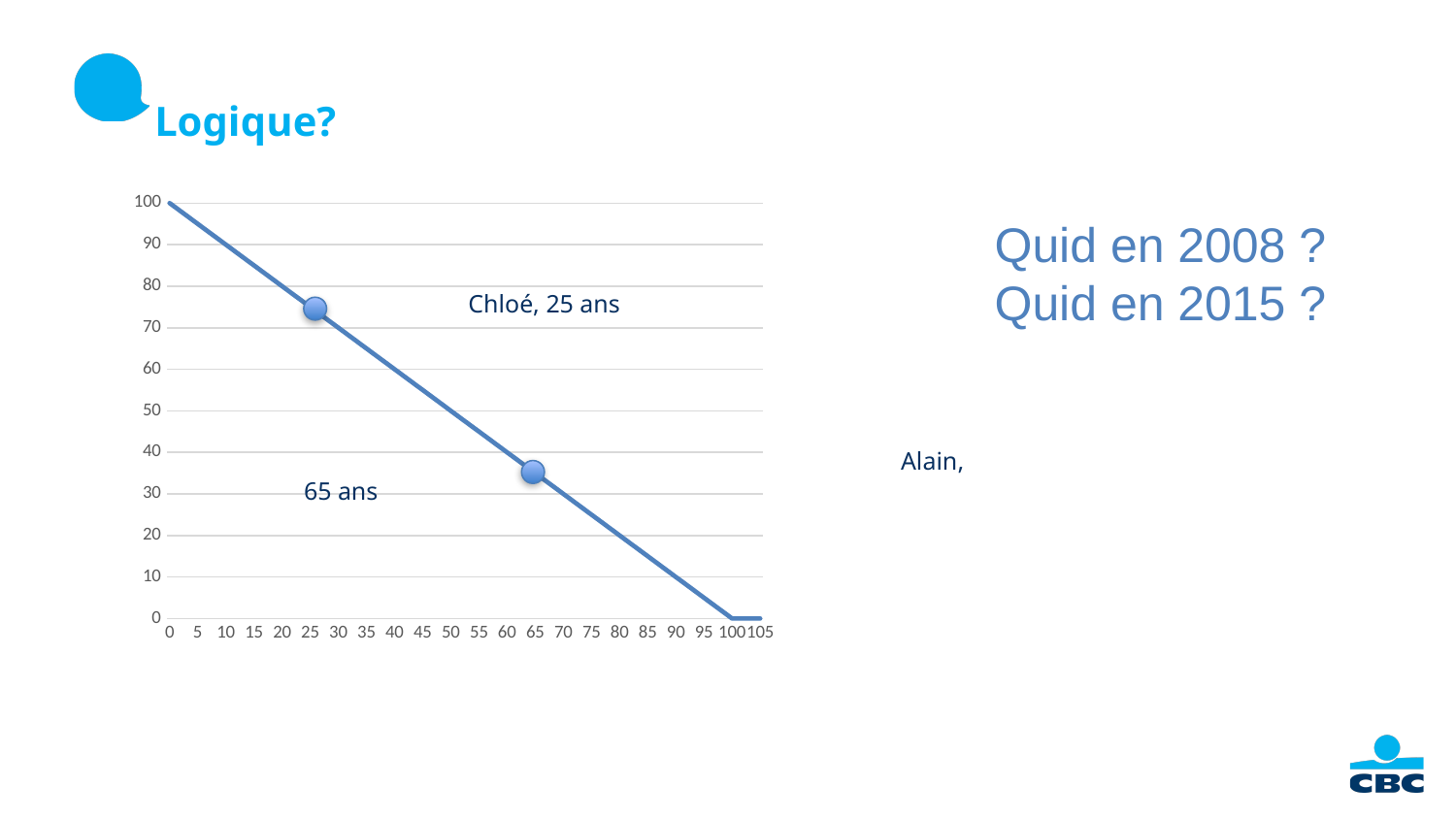
Is the value at the marker labelled 'Chloé, 25 ans' (x = 25) greater or less than 80? less What is the highest value shown on the vertical axis? 100 What is the value of the line at x = 100? 0 Do the values on the chart rise or fall as the x axis increases from 0 to 100? fall What is the value of the line at x = 0? 100 Which marker has the higher value: the one labelled 'Chloé, 25 ans' or the one labelled '65 ans'? Chloé, 25 ans Is the value at the marker labelled '65 ans' (x = 65) greater or less than 40? less What kind of chart is shown on the slide? line chart Is the value at the marker labelled '65 ans' (x = 65) greater or less than 30? greater How many highlighted markers are shown on the line? 2 At which x value does the line reach its highest value? 0